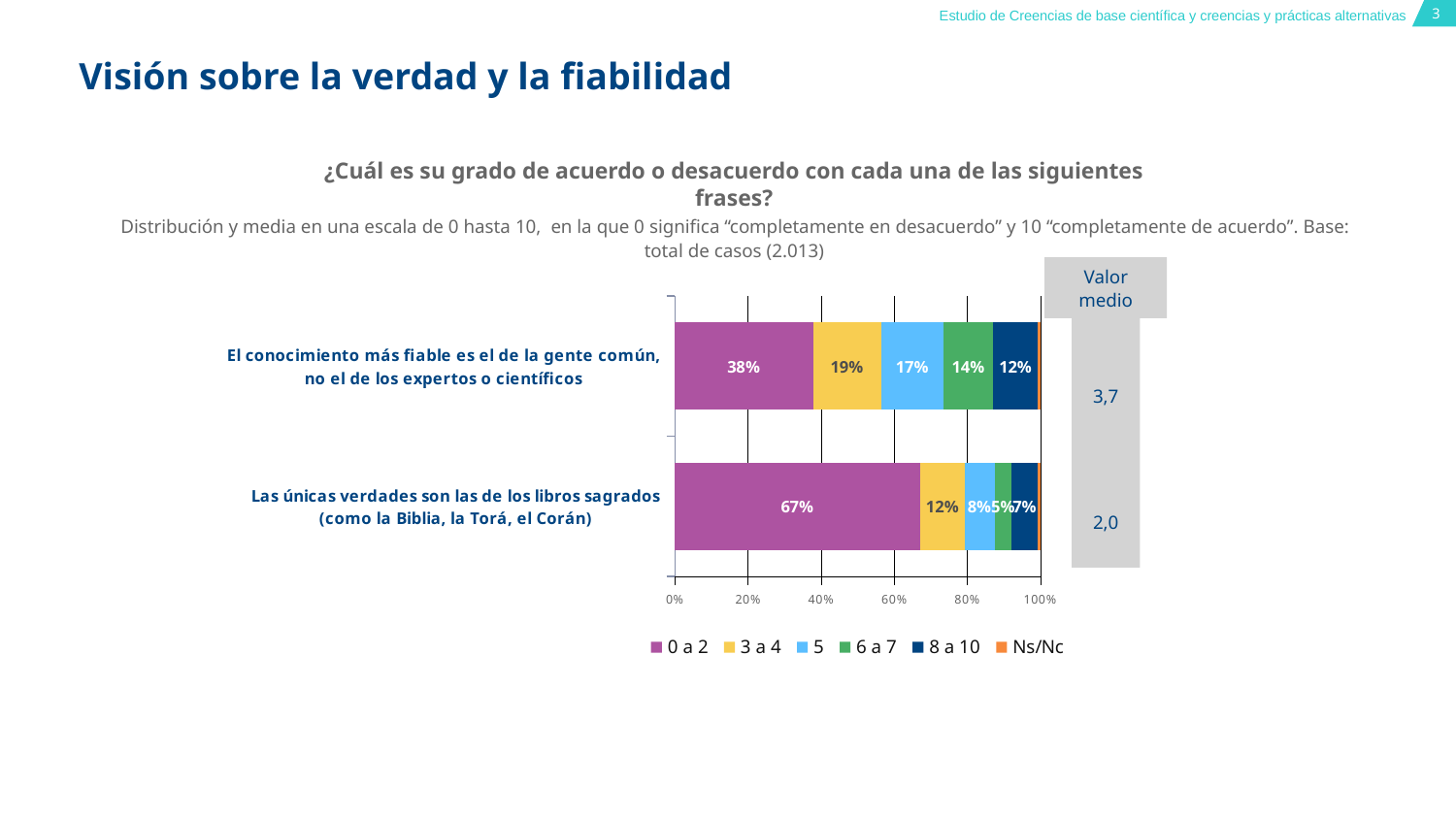
What is the value of the "0 a 2" segment for "Las únicas verdades son las de los libros sagrados (como la Biblia, la Torá, el Corán)"? 67% What is the value of the "5" segment for "Las únicas verdades son las de los libros sagrados (como la Biblia, la Torá, el Corán)"? 8% Which segment is the largest in the bar for "El conocimiento más fiable es el de la gente común, no el de los expertos o científicos"? 0 a 2 Which statement has the larger "6 a 7" segment? El conocimiento más fiable es el de la gente común, no el de los expertos o científicos What is the "Valor medio" shown for "Las únicas verdades son las de los libros sagrados (como la Biblia, la Torá, el Corán)"? 2,0 What is the value of the "0 a 2" segment for "El conocimiento más fiable es el de la gente común, no el de los expertos o científicos"? 38% Is the "0 a 2" value for "Las únicas verdades son las de los libros sagrados" greater or less than 60%? greater How many series does the legend list? 6 What is the difference between the "0 a 2" values of the two statements? 29 percentage points What is the value of the "8 a 10" segment for "El conocimiento más fiable es el de la gente común, no el de los expertos o científicos"? 12% How many categories (statements) are plotted in the chart? 2 What kind of chart is shown on the slide? stacked bar chart